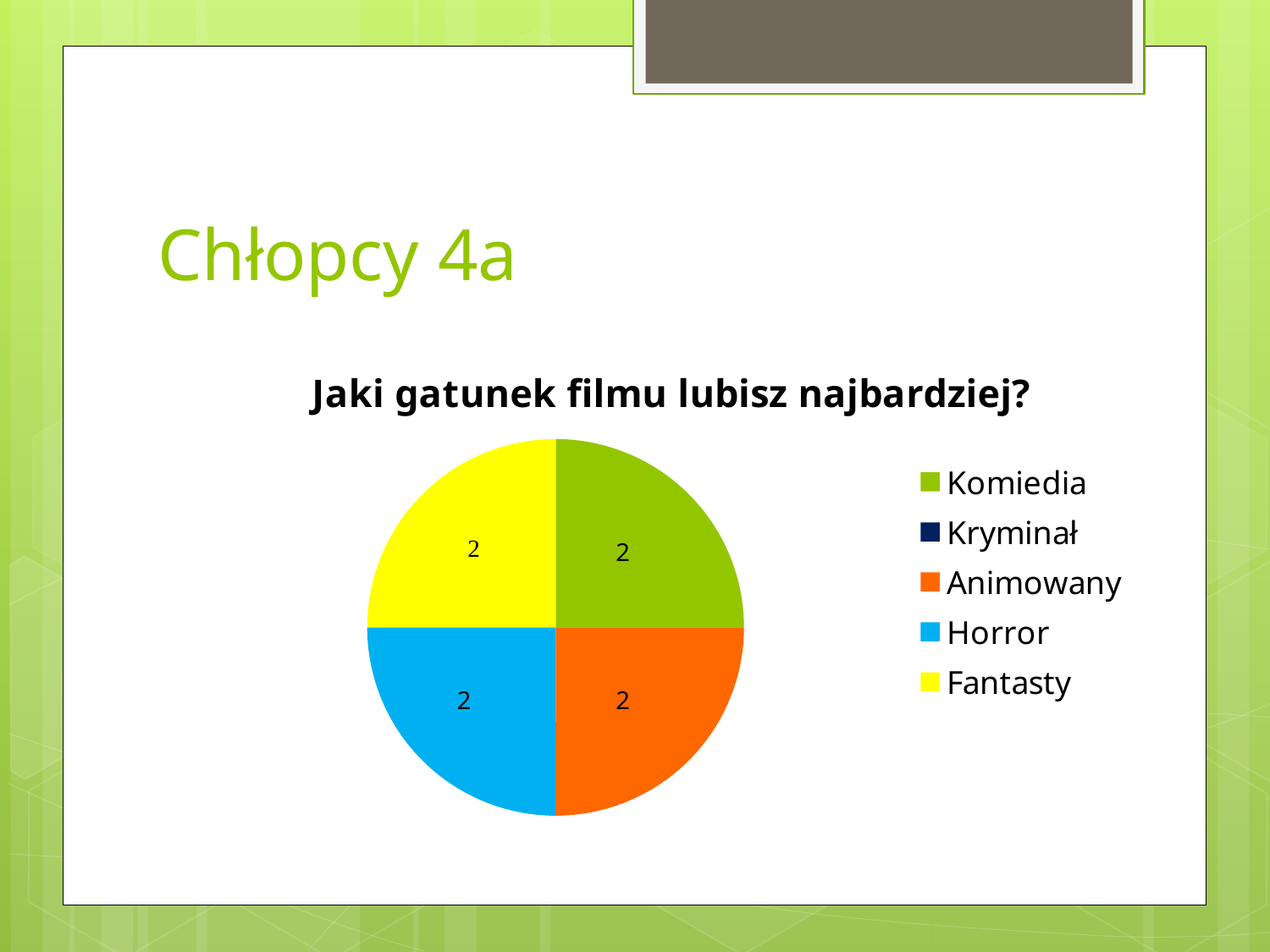
What type of chart is shown on the slide? pie chart What is the value shown for Komiedia? 2 How many entries does the legend list? 5 What is the value shown for Horror? 2 What is the value shown for Animowany? 2 Which colour represents Animowany in the legend? orange What is the title of the chart? Jaki gatunek filmu lubisz najbardziej? What is the difference between the values for Komiedia and Horror? 0 What share of the pie does the Fantasty slice represent? 25% How many slices are visible in the pie chart? 4 What is the total of the values labelled on the pie slices? 8 What is the value shown for Fantasty? 2